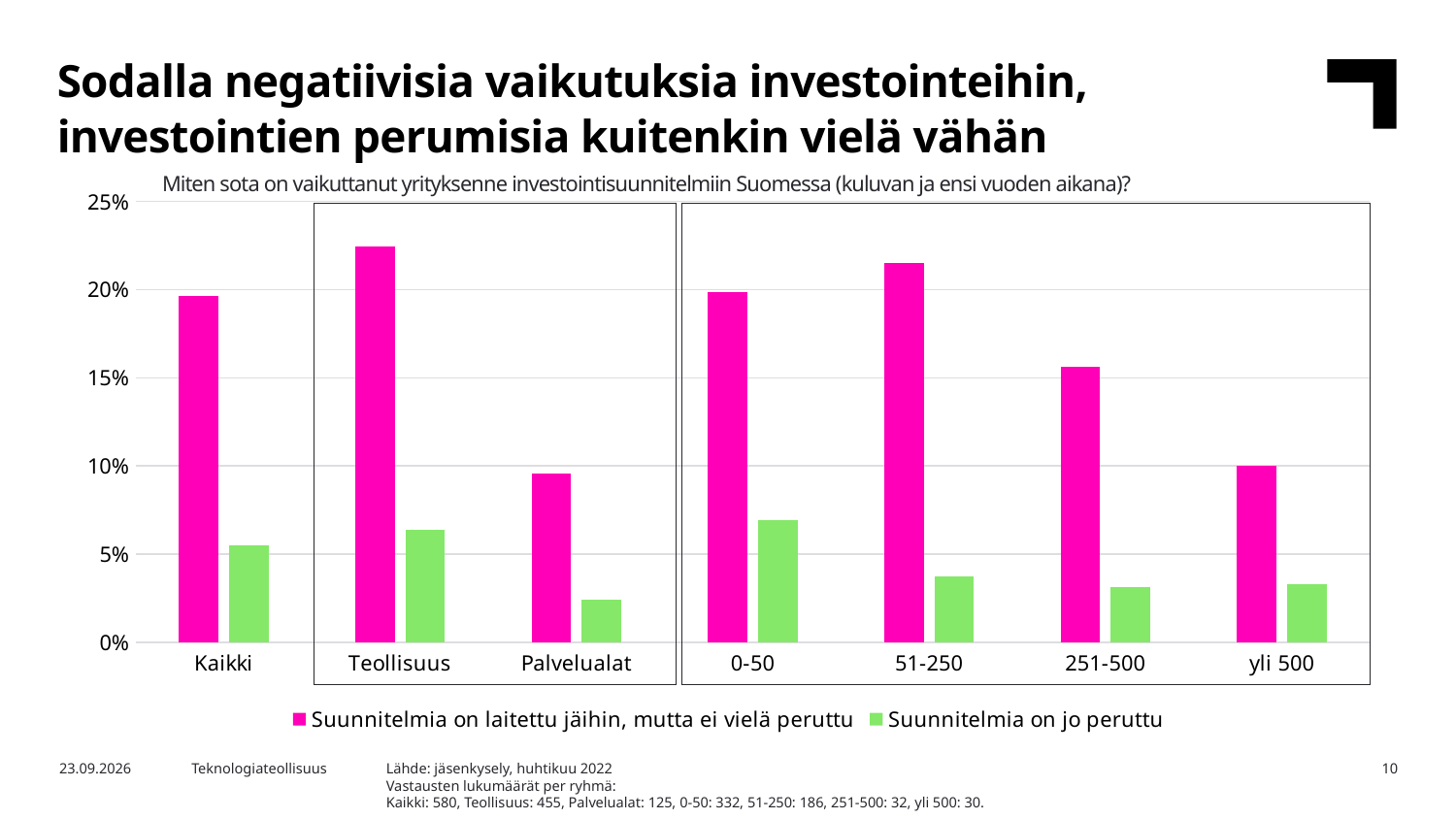
How many categories are shown on the x axis? 7 Is the value for 251-500 in the series 'Suunnitelmia on laitettu jäihin, mutta ei vielä peruttu' greater or less than 15%? greater Which is larger for 'Suunnitelmia on laitettu jäihin, mutta ei vielä peruttu': Kaikki or Palvelualat? Kaikki Is the value for 0-50 in the series 'Suunnitelmia on jo peruttu' greater or less than 5%? greater Which is larger for 'Suunnitelmia on jo peruttu': Teollisuus or 51-250? Teollisuus How many series does the legend list? 2 What kind of chart is shown on the slide? bar chart Which category has the highest value for 'Suunnitelmia on laitettu jäihin, mutta ei vielä peruttu'? Teollisuus What colour are the bars for the series 'Suunnitelmia on jo peruttu'? green Is the value for Teollisuus in the series 'Suunnitelmia on laitettu jäihin, mutta ei vielä peruttu' greater or less than 20%? greater Which category has the lowest value for 'Suunnitelmia on jo peruttu'? Palvelualat